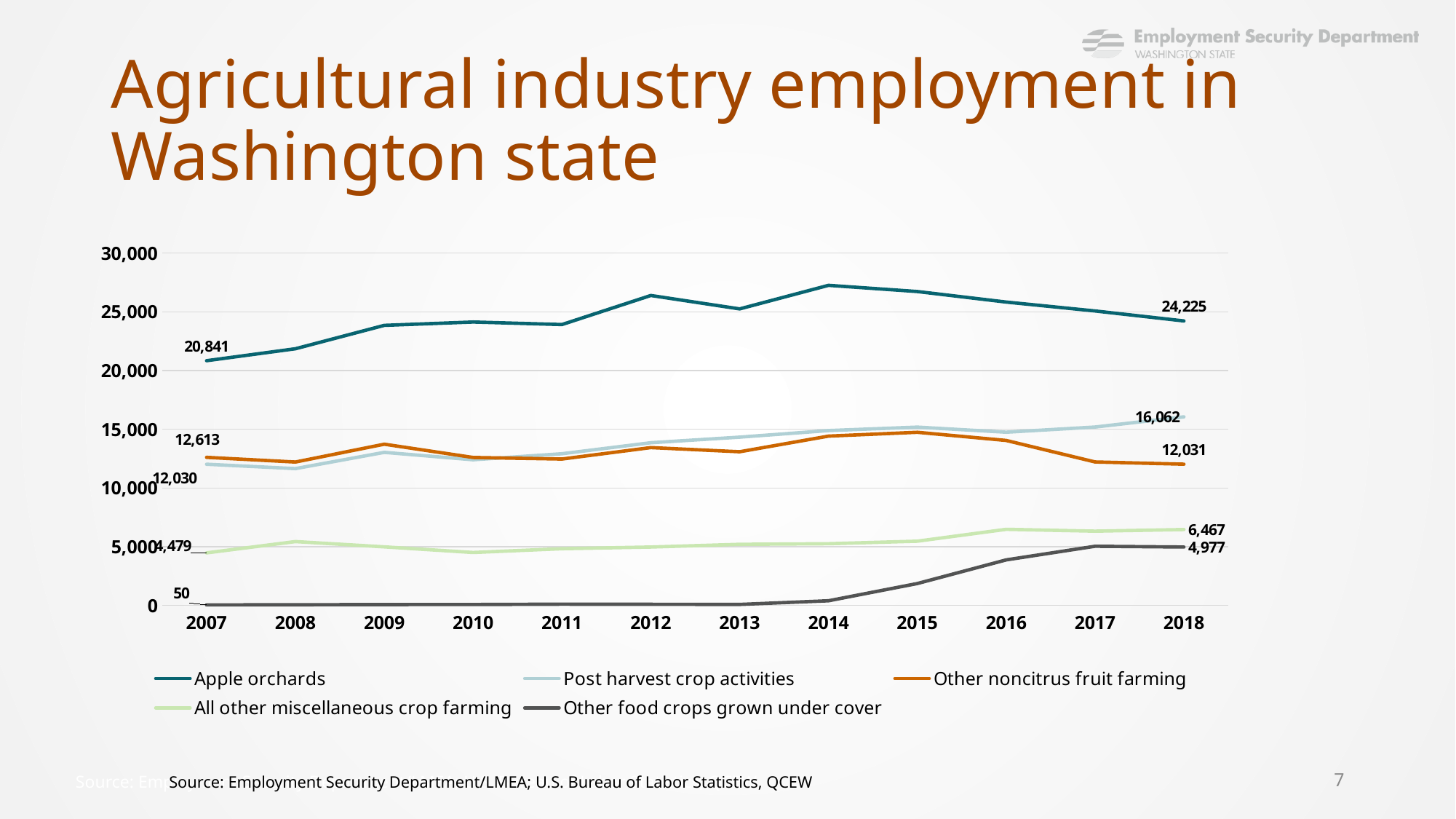
Is the value for Apple orchards in 2014 greater or less than 25,000? greater What is the value for Apple orchards in 2018? 24,225 What is the value for Apple orchards in 2007? 20,841 What is the value for Other food crops grown under cover in 2007? 50 Which series has the highest value in 2018? Apple orchards Which is larger in 2018: Post harvest crop activities or Other noncitrus fruit farming? Post harvest crop activities How many series does the legend list? 5 What type of chart is shown on the slide? line chart What is the value for Post harvest crop activities in 2018? 16,062 Which series has the lowest value in 2007? Other food crops grown under cover How many years are shown on the x axis? 12 What is the difference between the Apple orchards values in 2018 and 2007? 3,384